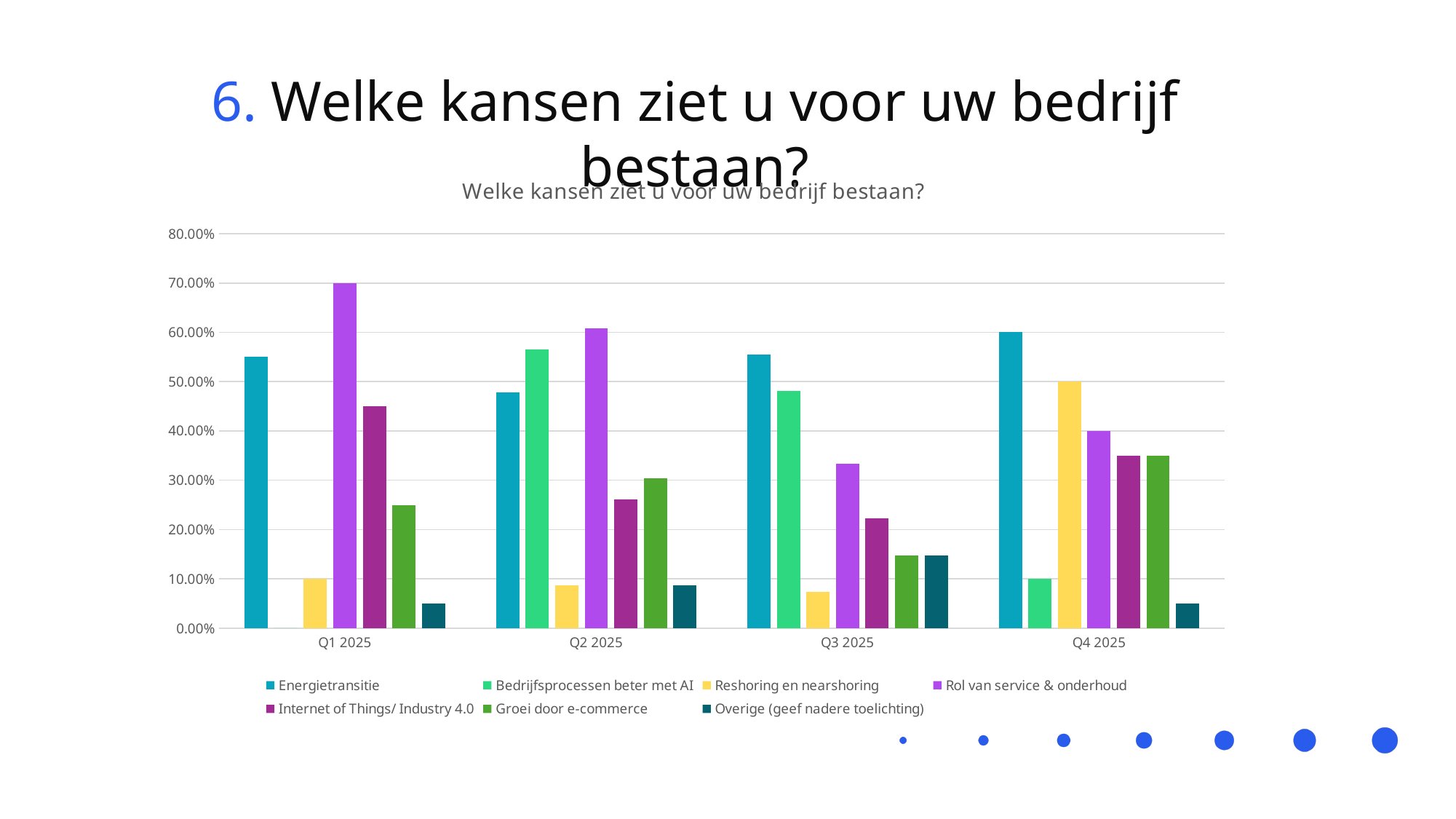
Which series has the highest value in Q3 2025? Energietransitie How many series does the legend list? 7 Is the value for Energietransitie in Q1 2025 greater or less than 50.00%? greater What is the value for Reshoring en nearshoring in Q4 2025? 50.00% What is the value for Rol van service & onderhoud in Q1 2025? 70.00% Is the value for Overige (geef nadere toelichting) in Q2 2025 greater or less than 10.00%? less In Q4 2025, which is larger: Reshoring en nearshoring or Rol van service & onderhoud? Reshoring en nearshoring What type of chart is shown on the slide? Bar chart What is the value for Energietransitie in Q4 2025? 60.00% How many quarters are shown on the x axis? 4 Which series has the highest value in Q1 2025? Rol van service & onderhoud Which series has the lowest value in Q3 2025? Reshoring en nearshoring